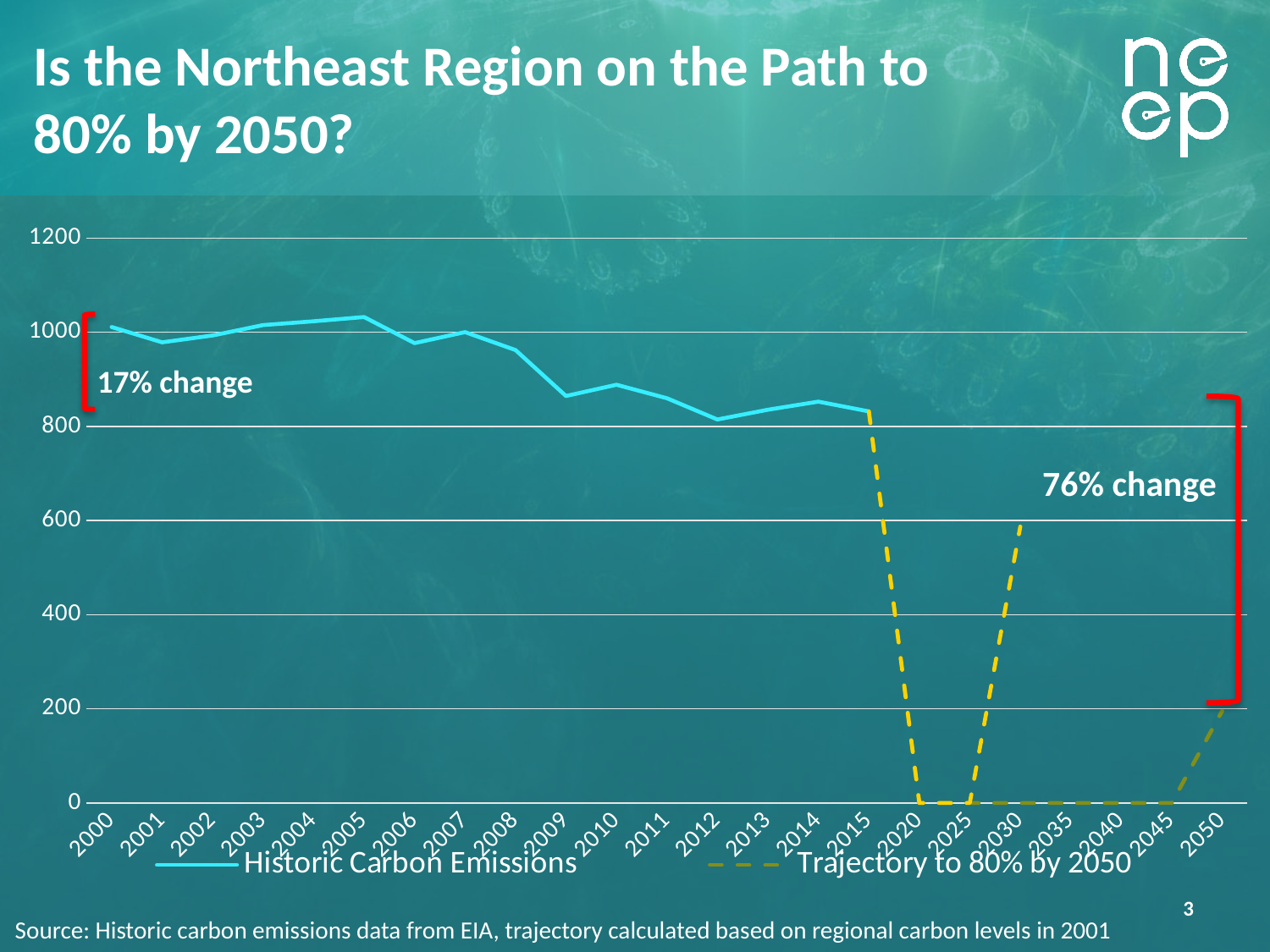
Which of the two series is drawn as a dashed line? Trajectory to 80% by 2050 Is the Historic Carbon Emissions value for 2008 greater or less than 1000? less Is the Historic Carbon Emissions value for 2009 greater or less than 800? greater How many series does the legend list? 2 Is the Historic Carbon Emissions value for 2010 larger or smaller than the value for 2000? smaller What percentage change is annotated on the right side of the chart near 2050? 76% change Is the Historic Carbon Emissions value for 2009 greater or less than 1000? less What are the two series named in the legend? Historic Carbon Emissions; Trajectory to 80% by 2050 What kind of chart is shown on the slide? Line chart What percentage change is annotated on the left side of the chart for the historic period? 17% change Do the Historic Carbon Emissions generally rise or fall from 2000 to 2015? fall